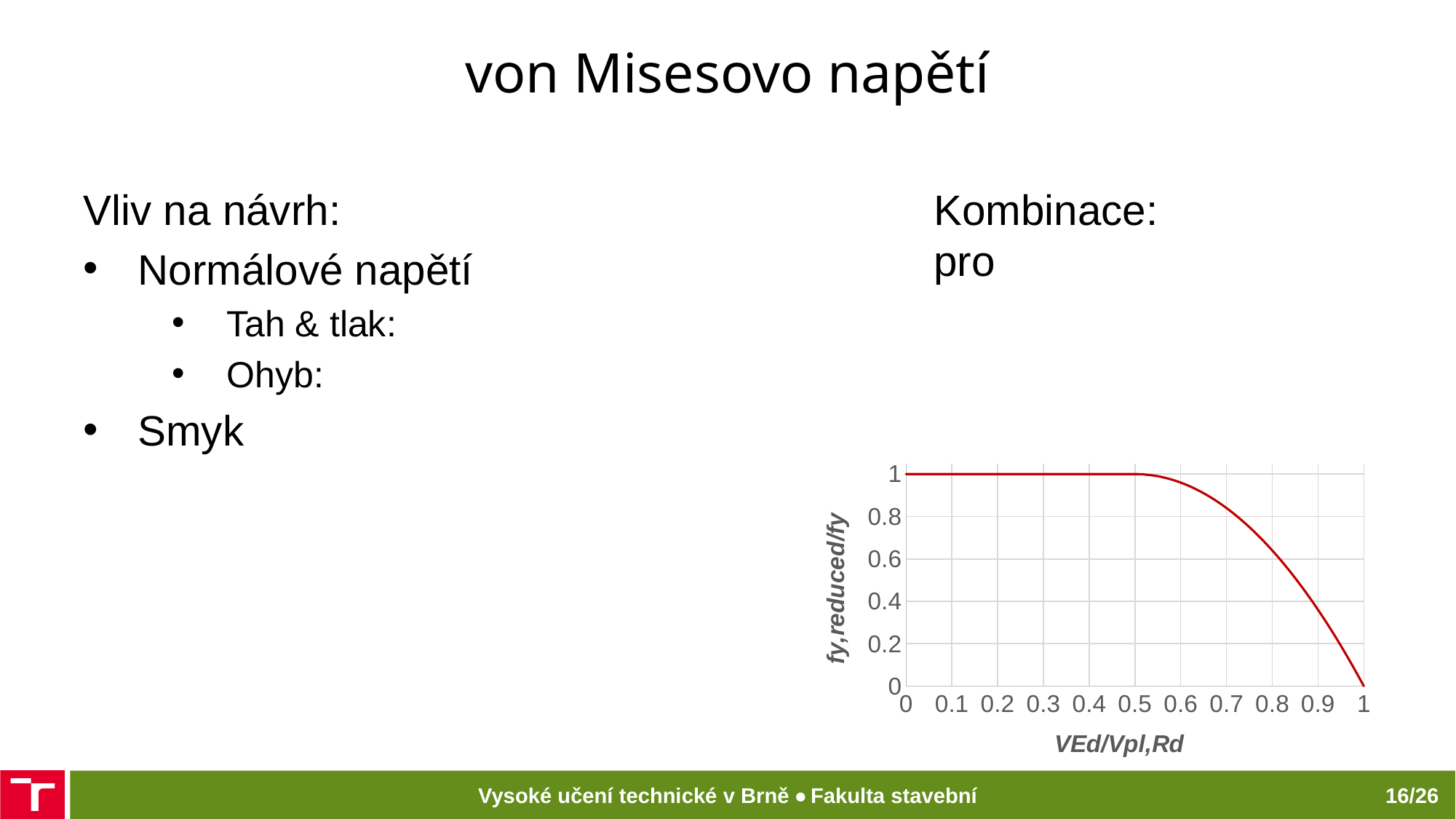
Between VEd/Vpl,Rd = 0.6 and 1, do the values of fy,reduced/fy rise or fall? fall What is the label of the y axis of the chart? fy,reduced/fy What is the value of fy,reduced/fy when VEd/Vpl,Rd is 0.3? 1 Is the value of fy,reduced/fy at VEd/Vpl,Rd = 0.9 greater or less than 0.6? less What kind of chart is shown on the slide? line chart What is the label of the x axis of the chart? VEd/Vpl,Rd What is the difference between fy,reduced/fy at VEd/Vpl,Rd = 0 and at VEd/Vpl,Rd = 1? 1 What is the value of fy,reduced/fy when VEd/Vpl,Rd is 0? 1 What is the value of fy,reduced/fy when VEd/Vpl,Rd is 1? 0 Which is larger: fy,reduced/fy at VEd/Vpl,Rd = 0.2 or at VEd/Vpl,Rd = 0.9? at 0.2 At which value of VEd/Vpl,Rd is fy,reduced/fy lowest? 1